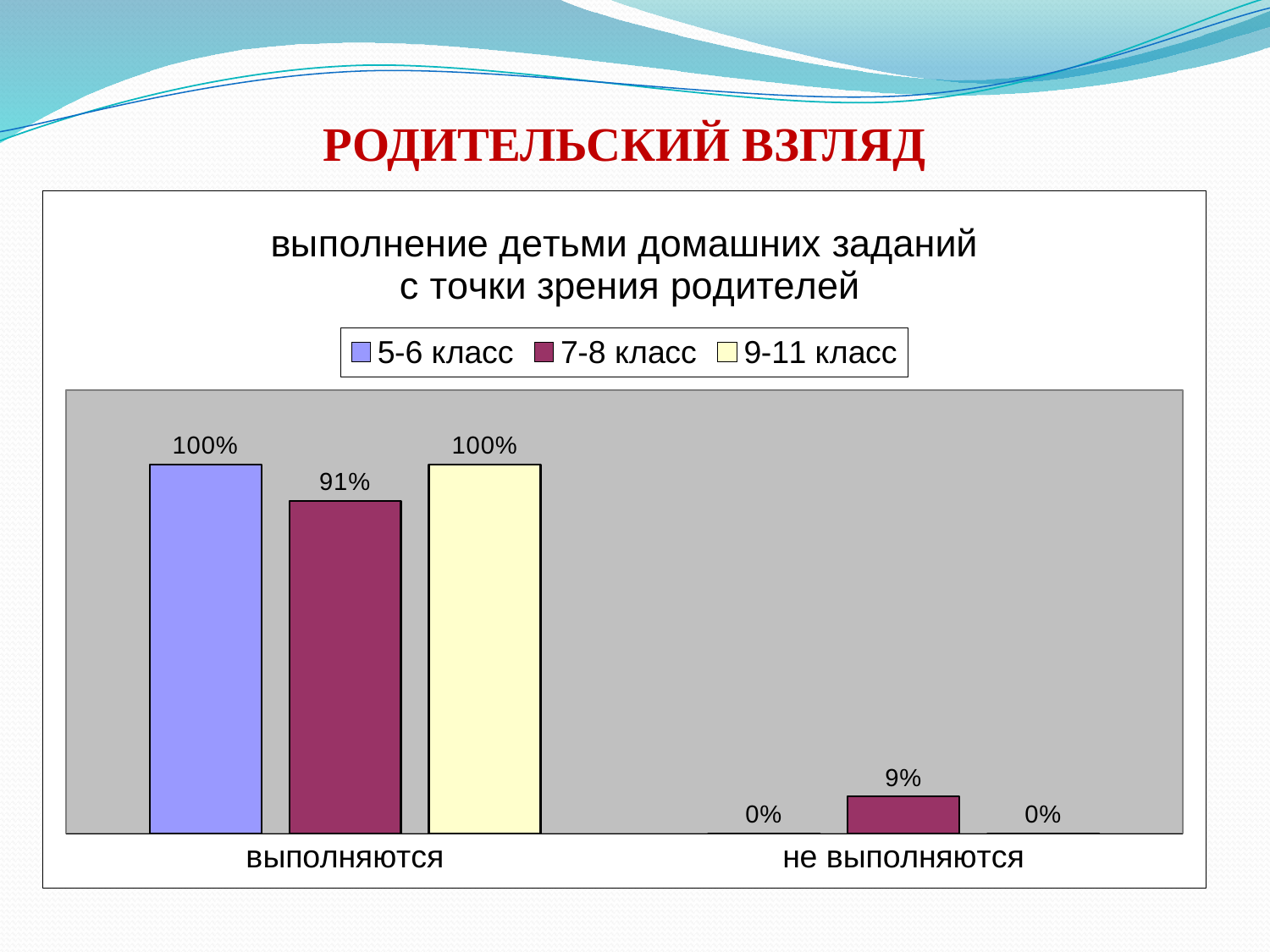
What is the value for 9-11 класс in the не выполняются category? 0% Which series has the lowest value in the выполняются category? 7-8 класс Which series has the highest value in the не выполняются category? 7-8 класс What is the difference between the 5-6 класс and 7-8 класс values in the выполняются category? 9% What is the value for 5-6 класс in the выполняются category? 100% Which is larger: the 7-8 класс value for выполняются or for не выполняются? выполняются What is the value for 7-8 класс in the не выполняются category? 9% What is the value for 7-8 класс in the выполняются category? 91% What is the title of the chart? выполнение детьми домашних заданий с точки зрения родителей How many categories are shown on the x axis? 2 How many series does the legend list? 3 What kind of chart is shown on the slide? bar chart